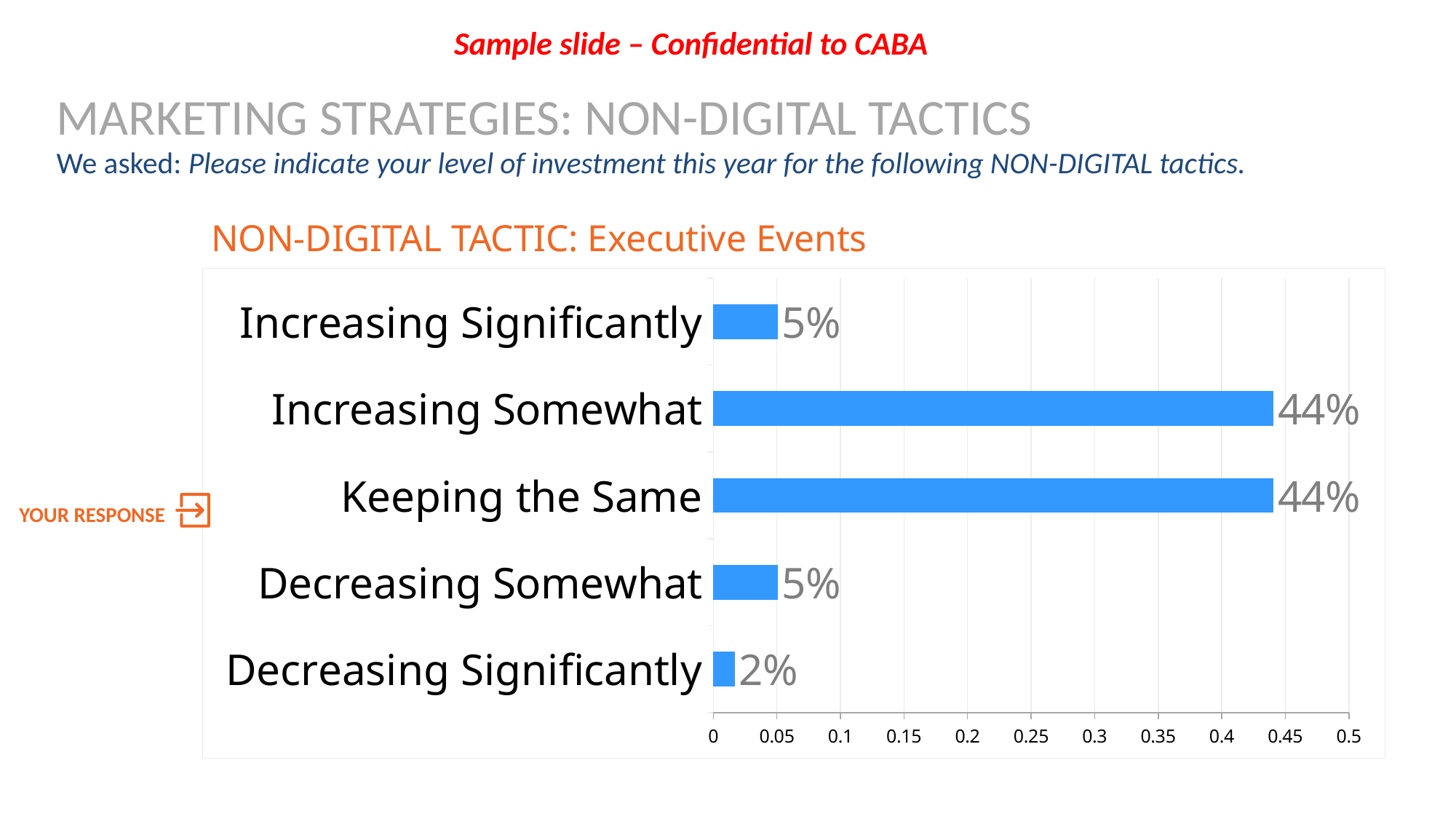
What is the value for Increasing Somewhat? 44% What is the difference between the values for Increasing Significantly and Decreasing Significantly? 3% What is the difference between the values for Keeping the Same and Decreasing Somewhat? 39% How many categories are shown in the chart? 5 What is the value for Decreasing Significantly? 2% Which is larger, the value for Increasing Somewhat or the value for Decreasing Somewhat? Increasing Somewhat What is the value for Increasing Significantly? 5% What is the title of the chart? NON-DIGITAL TACTIC: Executive Events What is the value for Keeping the Same? 44% Which category has the lowest value? Decreasing Significantly What kind of chart is shown on the slide? bar chart Is the value for Keeping the Same greater or less than 0.4 on the axis? greater